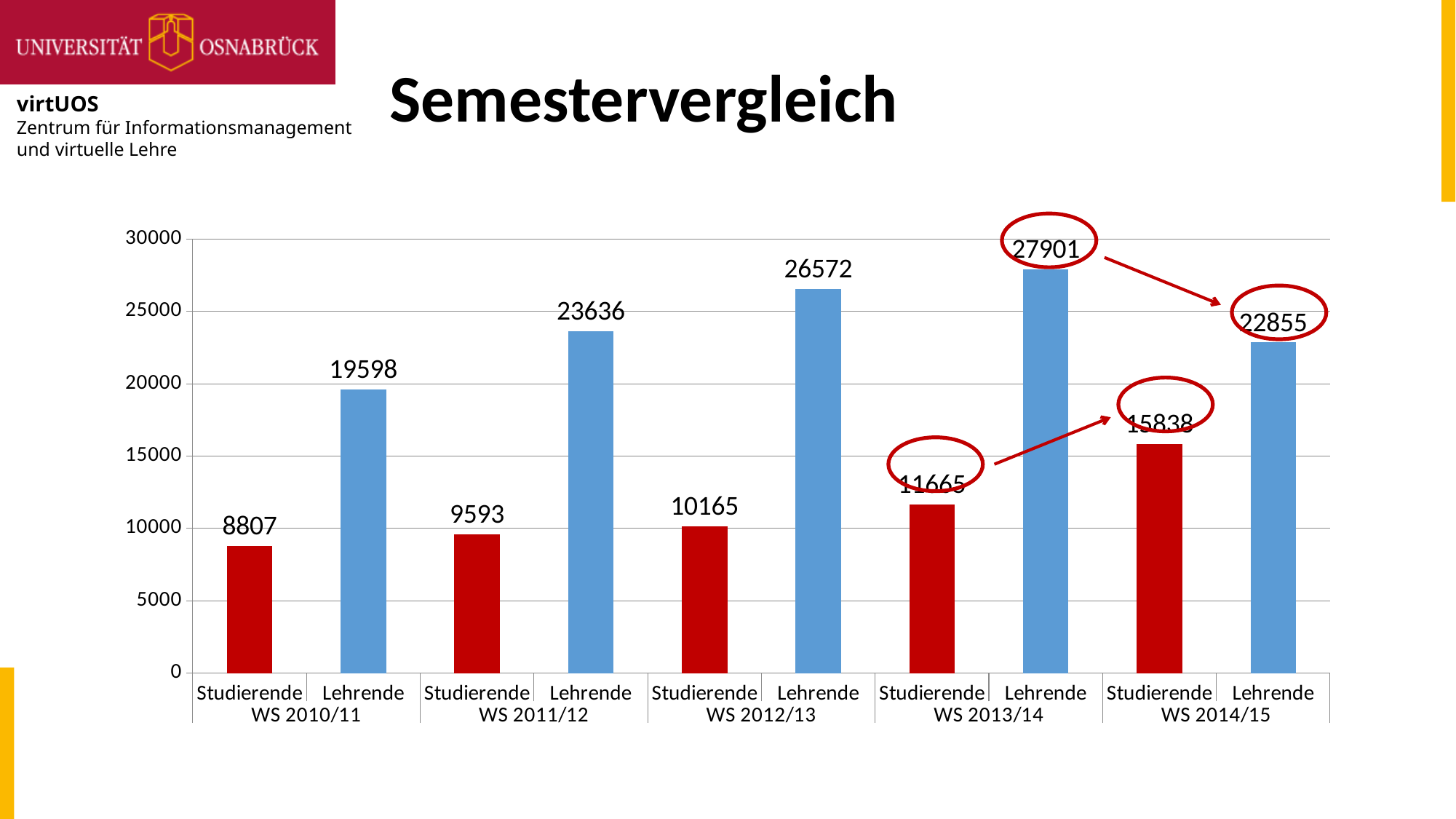
What is the difference between Lehrende in WS 2013/14 and Lehrende in WS 2014/15? 5046 How many bars are plotted in the chart? 10 What is the value for Lehrende in WS 2012/13? 26572 What is the value for Studierende in WS 2010/11? 8807 What is the value for Studierende in WS 2014/15? 15838 Which is larger: Lehrende in WS 2011/12 or Lehrende in WS 2014/15? Lehrende in WS 2011/12 What is the title of the slide containing the chart? Semestervergleich What kind of chart is shown on the slide? bar chart Which bar has the lowest value in the chart? Studierende WS 2010/11 Which bar has the highest value in the chart? Lehrende WS 2013/14 Do the Studierende values rise or fall from WS 2010/11 to WS 2014/15? rise What is the difference between Studierende in WS 2014/15 and Studierende in WS 2013/14? 4173